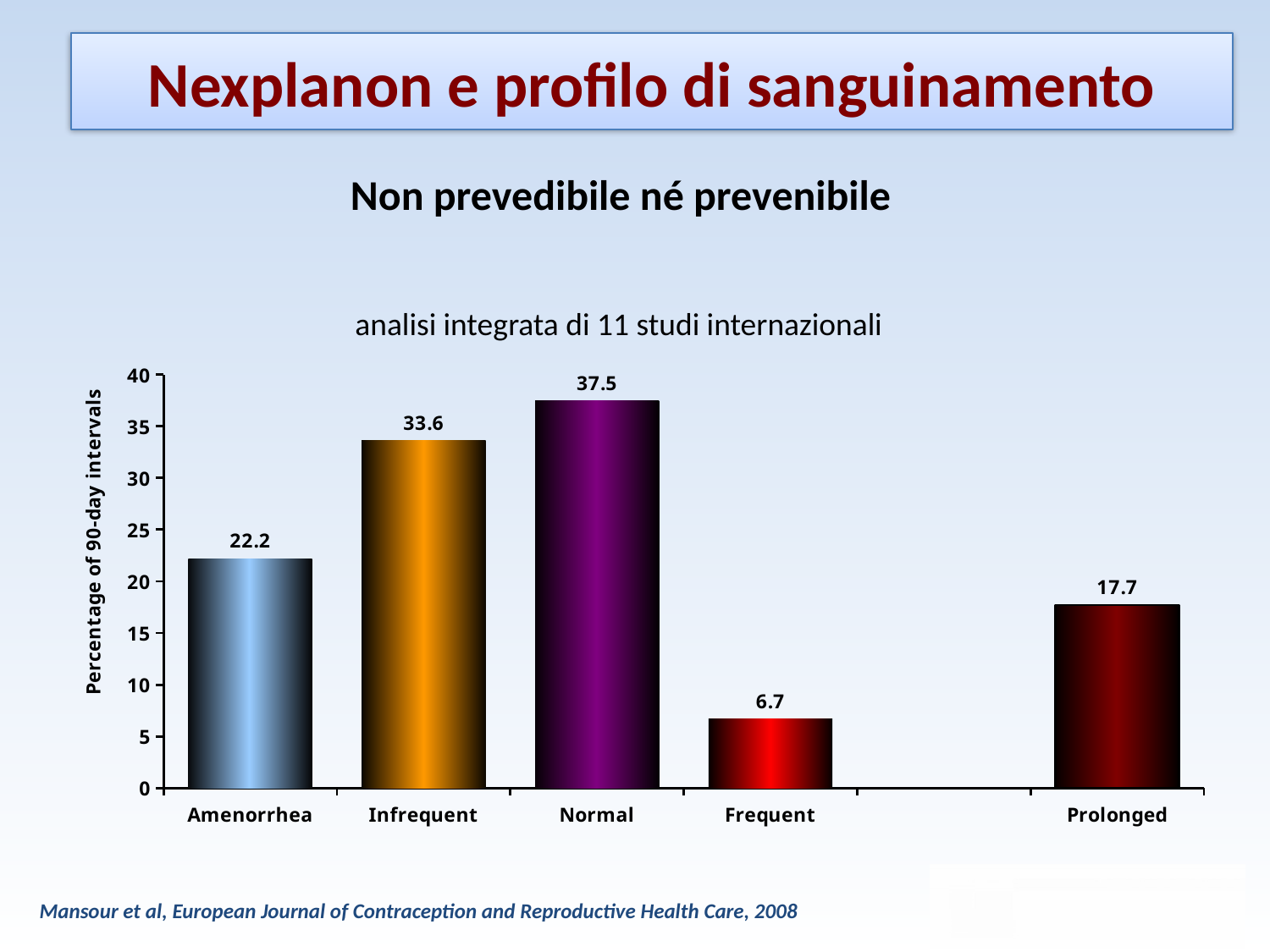
What is the value for Normal? 37.5 What is the value for Amenorrhea? 22.2 How many bars are plotted in the chart? 5 Which category has the highest value? Normal What is the difference between the values for Normal and Infrequent? 3.9 What is the label of the vertical axis? Percentage of 90-day intervals Which is larger, the value for Infrequent or the value for Amenorrhea? Infrequent What is the value for Prolonged? 17.7 What kind of chart is shown on the slide? bar chart What is the difference between the values for Amenorrhea and Prolonged? 4.5 Which category has the lowest value? Frequent Is the value for Frequent greater or less than 10? less